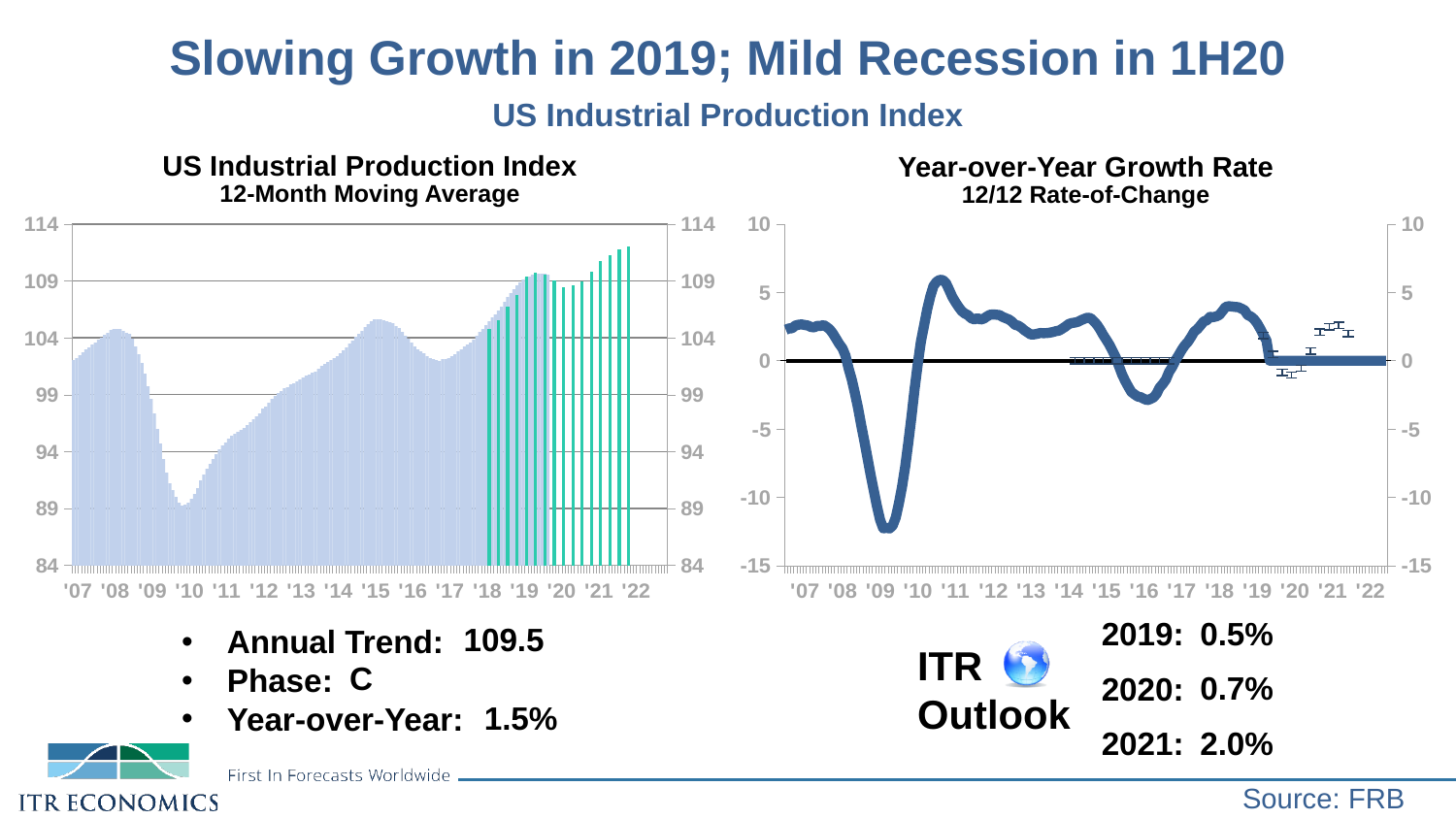
On the right chart, 'Year-over-Year Growth Rate', is the lowest value around '09 greater or less than -10? less On the left chart, 'US Industrial Production Index 12-Month Moving Average', is the value at '22 greater or less than 109? greater What is the range of the y axis on the right chart, 'Year-over-Year Growth Rate'? -15 to 10 On the left chart, 'US Industrial Production Index 12-Month Moving Average', is the value around '13 greater or less than 104? less On the right chart, 'Year-over-Year Growth Rate', in which year does the line reach its lowest point? '09 On the right chart, 'Year-over-Year Growth Rate', in which year does the line reach its highest point? '11 What kind of chart is the right chart, 'Year-over-Year Growth Rate 12/12 Rate-of-Change'? line chart How many year labels are shown on the x axis of the left chart, 'US Industrial Production Index 12-Month Moving Average'? 16 What kind of chart is the left chart, 'US Industrial Production Index 12-Month Moving Average'? bar chart On the left chart, 'US Industrial Production Index 12-Month Moving Average', do the values rise or fall from '17 to '22? rise